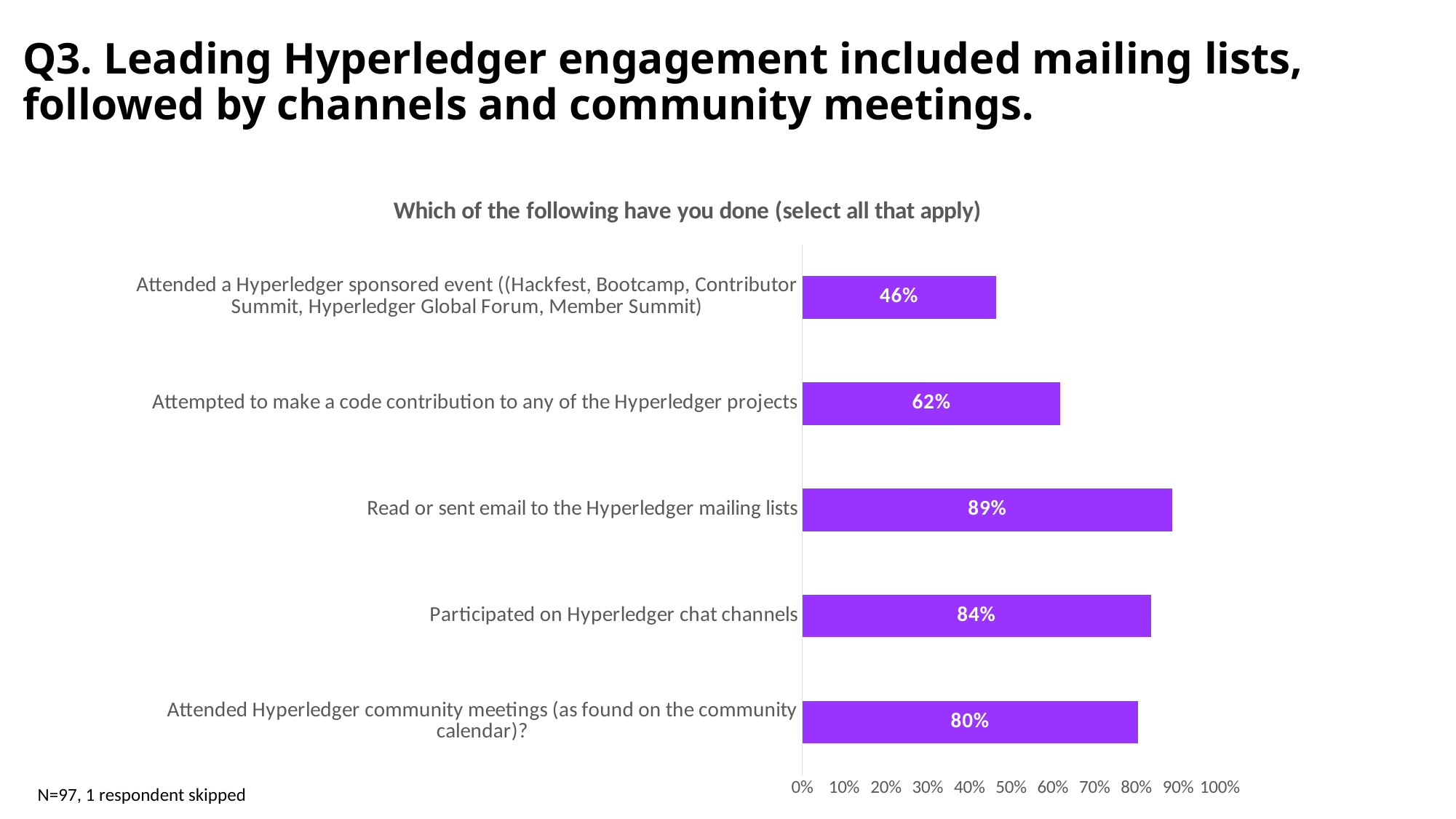
What percentage of respondents attempted to make a code contribution to any of the Hyperledger projects? 62% How many activities are shown in the chart? 5 What is the difference in percentage points between reading or sending email to the mailing lists and participating on chat channels? 5 percentage points Which activity has the highest percentage of respondents? Read or sent email to the Hyperledger mailing lists Which is larger: the percentage who attempted a code contribution or the percentage who attended a Hyperledger sponsored event? Attempted to make a code contribution What is the title of the chart? Which of the following have you done (select all that apply) What type of chart is shown on the slide? Bar chart What percentage of respondents attended Hyperledger community meetings? 80% What percentage of respondents attended a Hyperledger sponsored event? 46% What percentage of respondents participated on Hyperledger chat channels? 84% Which activity has the lowest percentage of respondents? Attended a Hyperledger sponsored event What percentage of respondents read or sent email to the Hyperledger mailing lists? 89%